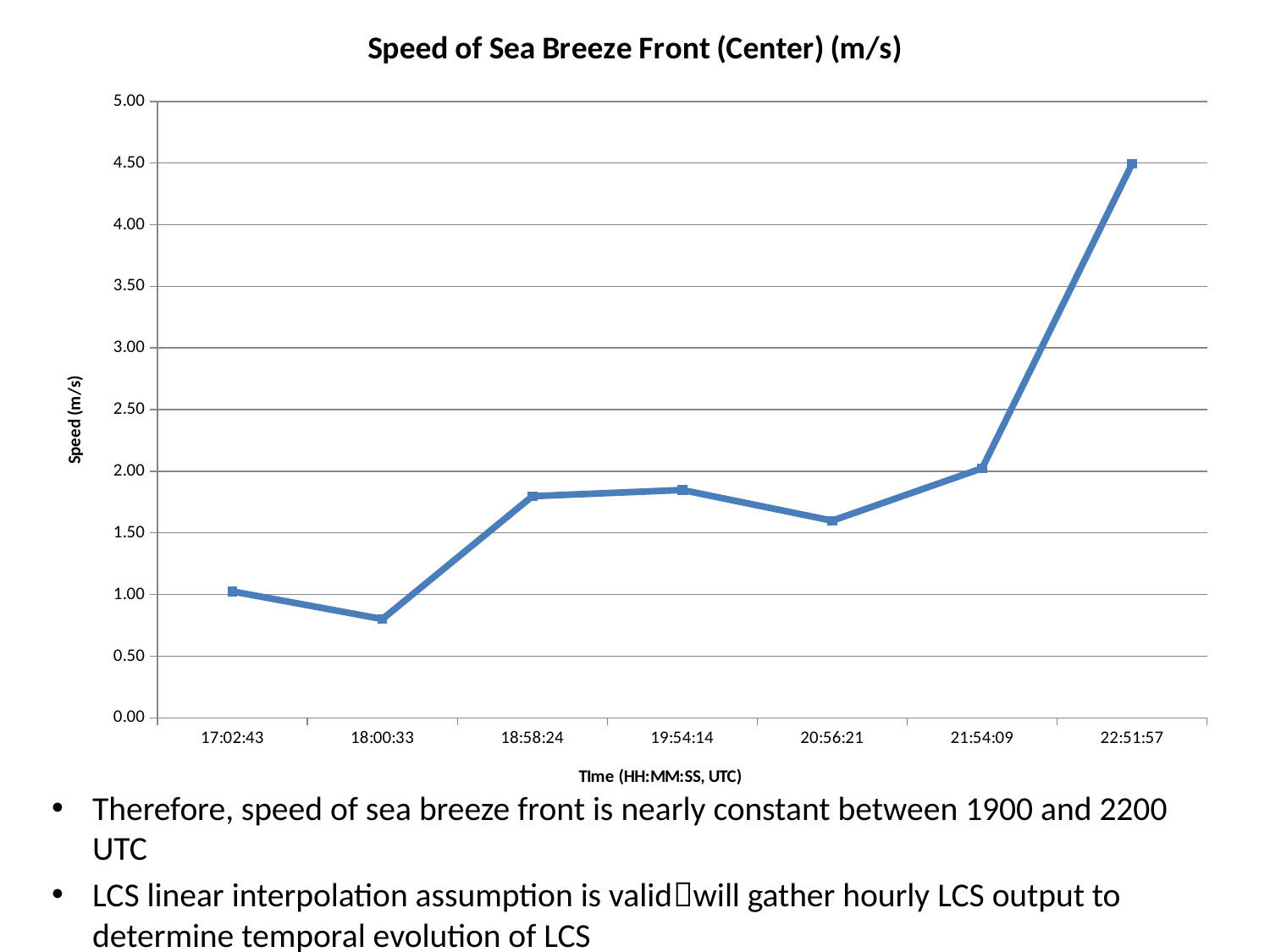
Is the value for 20:56:21 greater or less than 1.50? greater Is the value for 18:00:33 greater or less than 1.00? less How many time points are plotted on the chart? 7 What is the label of the y axis? Speed (m/s) Which has the larger speed, 19:54:14 or 20:56:21? 19:54:14 At which time is the speed of the sea breeze front highest? 22:51:57 Is the value for 18:58:24 greater or less than 2.00? less Does the speed rise or fall between 21:54:09 and 22:51:57? rise What kind of chart is shown on the slide? line chart At which time is the speed of the sea breeze front lowest? 18:00:33 Which has the larger speed, 18:00:33 or 18:58:24? 18:58:24